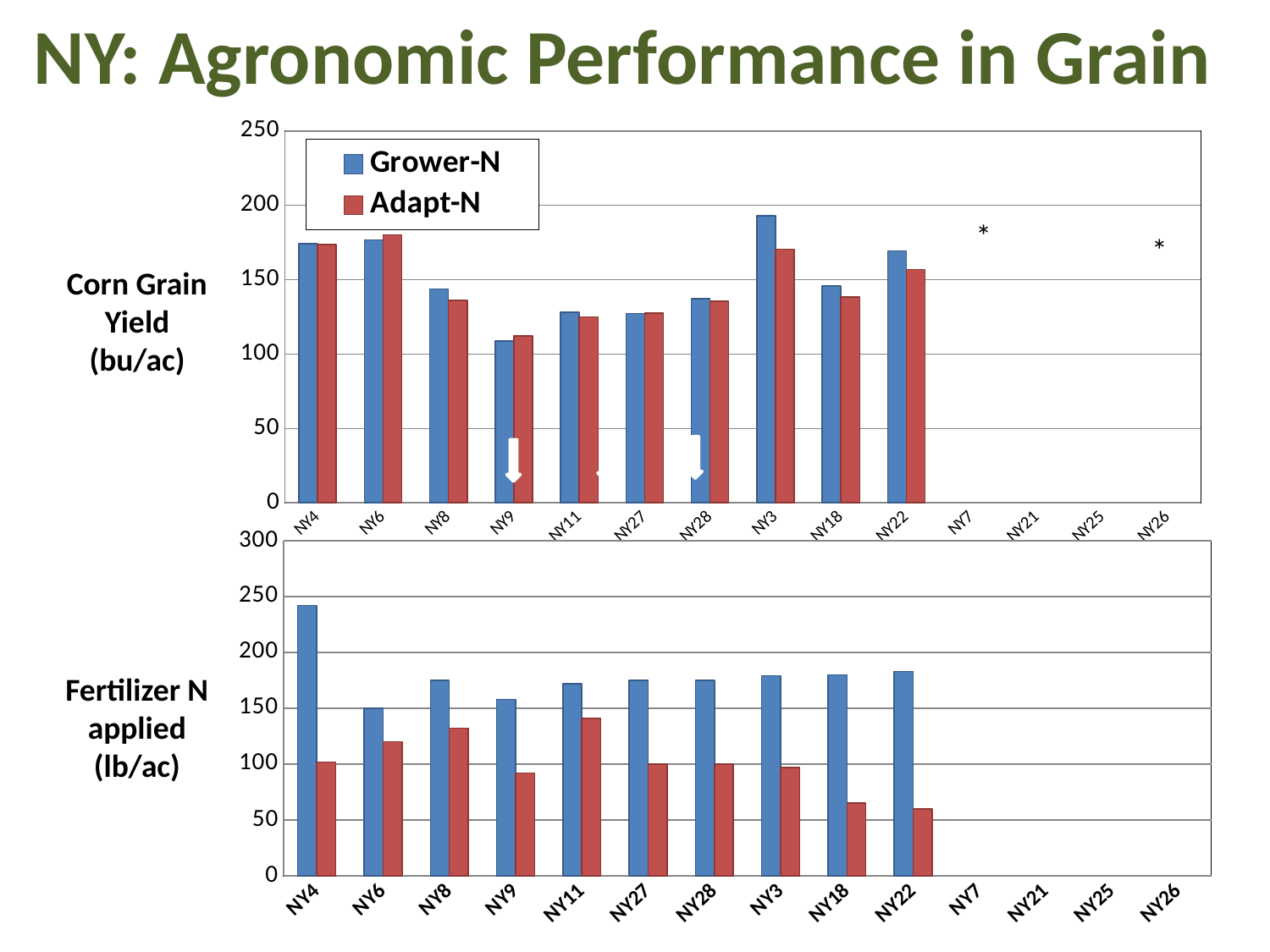
In the top chart (Corn Grain Yield), which site has the highest Grower-N bar? NY3 In the bottom chart (Fertilizer N applied), is the Grower-N value for NY4 greater or less than 200? greater In the bottom chart (Fertilizer N applied), is the Adapt-N value for NY22 greater or less than 100? less In the top chart (Corn Grain Yield), which site has the lowest Grower-N bar? NY9 How many site labels appear along the x axis of the bottom chart (Fertilizer N applied)? 14 In the top chart (Corn Grain Yield), at NY3, which is larger: Grower-N or Adapt-N? Grower-N In the top chart (Corn Grain Yield), is the Adapt-N value for NY9 greater or less than 150? less In the bottom chart (Fertilizer N applied), which site has the highest Grower-N bar? NY4 What are the two series named in the legend of the top chart? Grower-N and Adapt-N How many series does the legend on the top chart list? 2 What kind of chart is the top chart (Corn Grain Yield)? bar chart